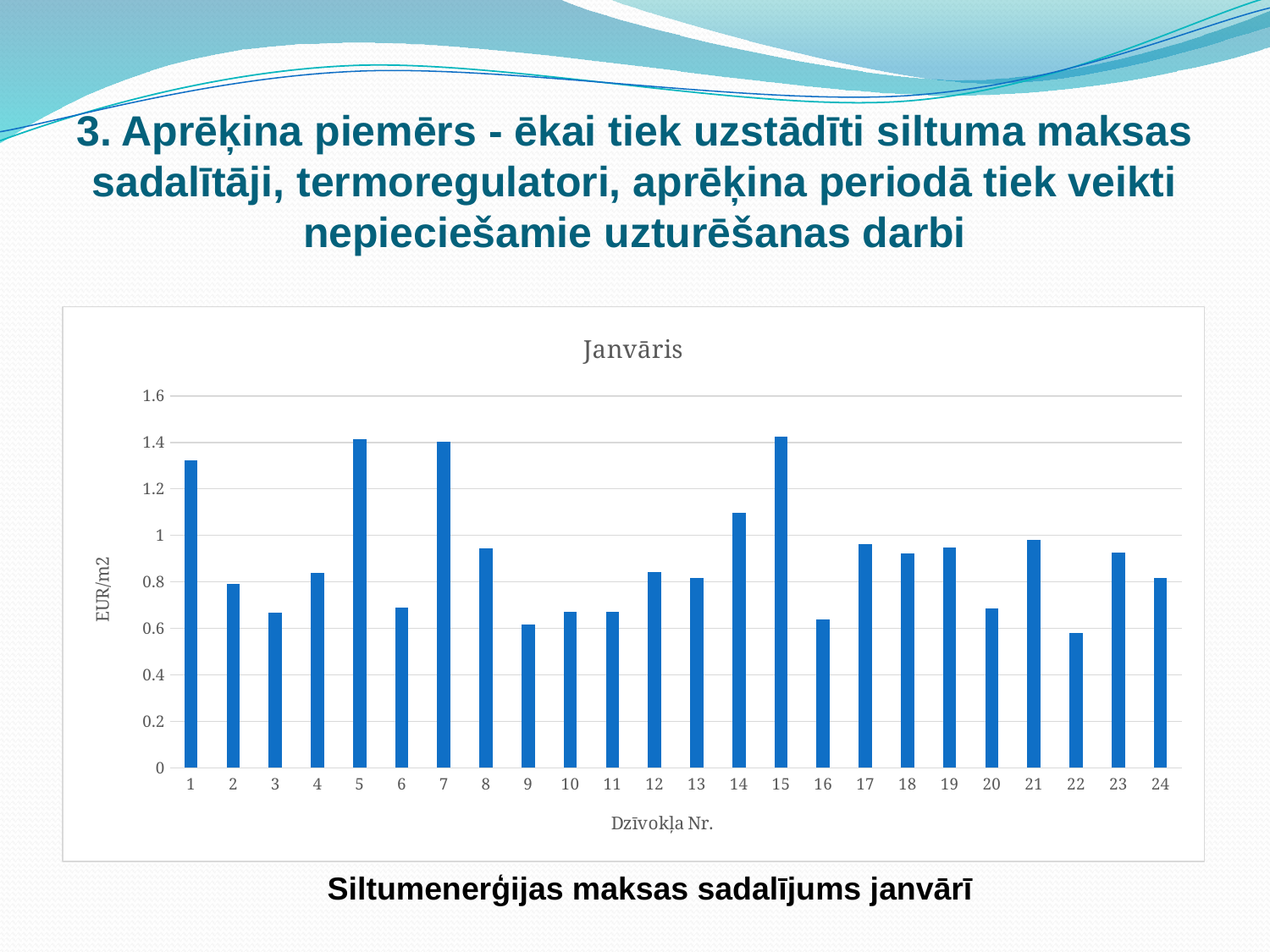
What kind of chart is shown on the slide? bar chart Is the value for apartment 3 greater or less than 0.8? less Is the value for apartment 9 greater or less than 0.8? less Which has the larger value, apartment 21 or apartment 22? apartment 21 Is the value for apartment 14 greater or less than 1? greater Which has the larger value, apartment 13 or apartment 14? apartment 14 What is the title of the chart? Janvāris What is the label of the vertical axis of the chart? EUR/m2 Which has the larger value, apartment 1 or apartment 2? apartment 1 How many apartments (Dzīvokļa Nr.) are shown on the x axis of the chart? 24